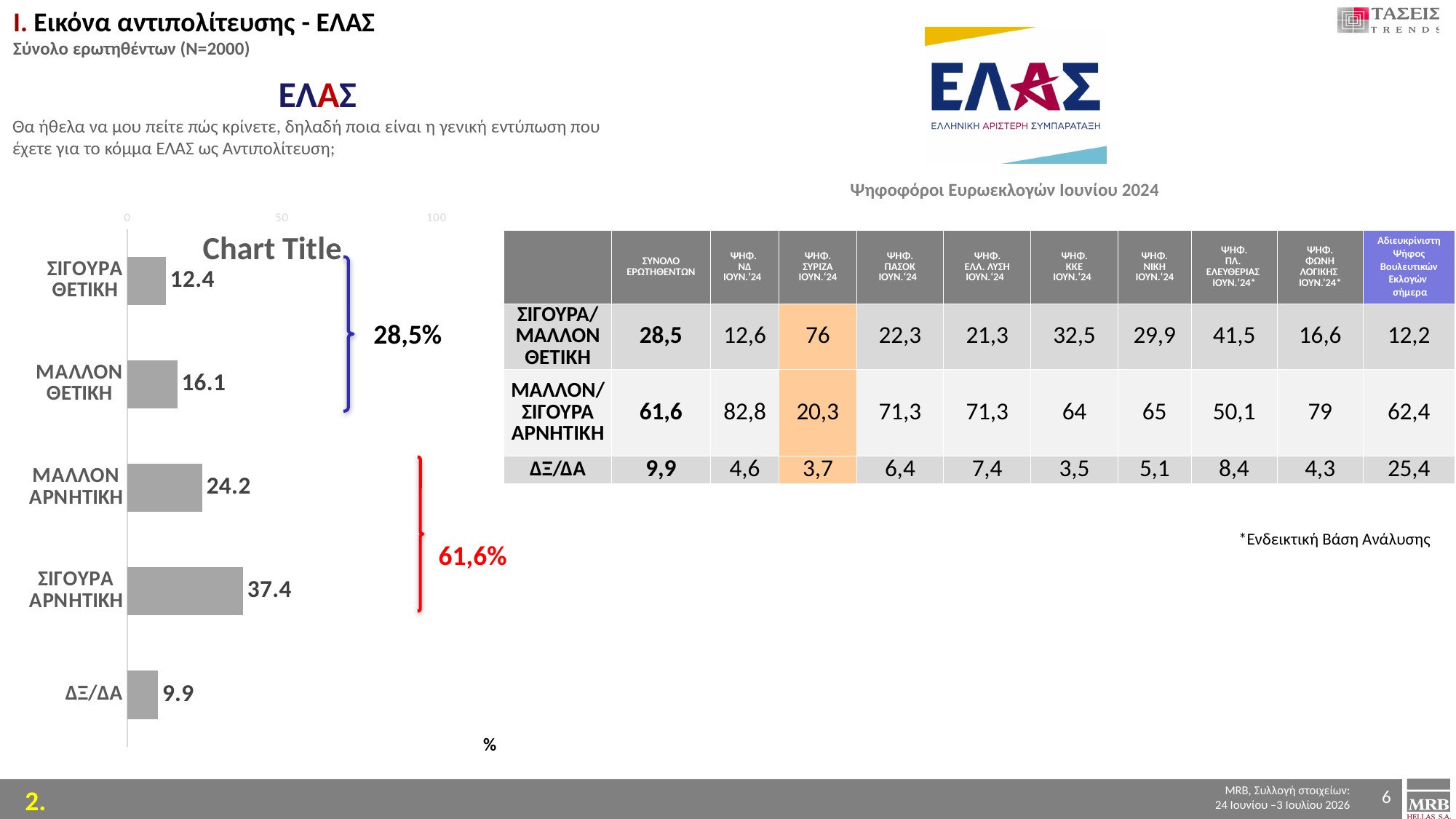
Which category has the lowest value in the bar chart? ΔΞ/ΔΑ Which category has the highest value in the bar chart? ΣΙΓΟΥΡΑ ΑΡΝΗΤΙΚΗ What is the value for ΔΞ/ΔΑ in the bar chart? 9.9 What is the value for ΜΑΛΛΟΝ ΘΕΤΙΚΗ in the bar chart? 16.1 Is the value for ΣΙΓΟΥΡΑ ΑΡΝΗΤΙΚΗ in the bar chart greater or less than 50? less What is the value for ΣΙΓΟΥΡΑ ΘΕΤΙΚΗ in the bar chart? 12.4 Which is larger in the bar chart, ΜΑΛΛΟΝ ΘΕΤΙΚΗ or ΣΙΓΟΥΡΑ ΘΕΤΙΚΗ? ΜΑΛΛΟΝ ΘΕΤΙΚΗ What is the difference between the values for ΣΙΓΟΥΡΑ ΑΡΝΗΤΙΚΗ and ΜΑΛΛΟΝ ΑΡΝΗΤΙΚΗ in the bar chart? 13.2 What kind of chart is shown on the left of the slide? bar chart What is the value for ΜΑΛΛΟΝ ΑΡΝΗΤΙΚΗ in the bar chart? 24.2 How many categories are shown in the bar chart? 5 What is the value for ΣΙΓΟΥΡΑ ΑΡΝΗΤΙΚΗ in the bar chart? 37.4